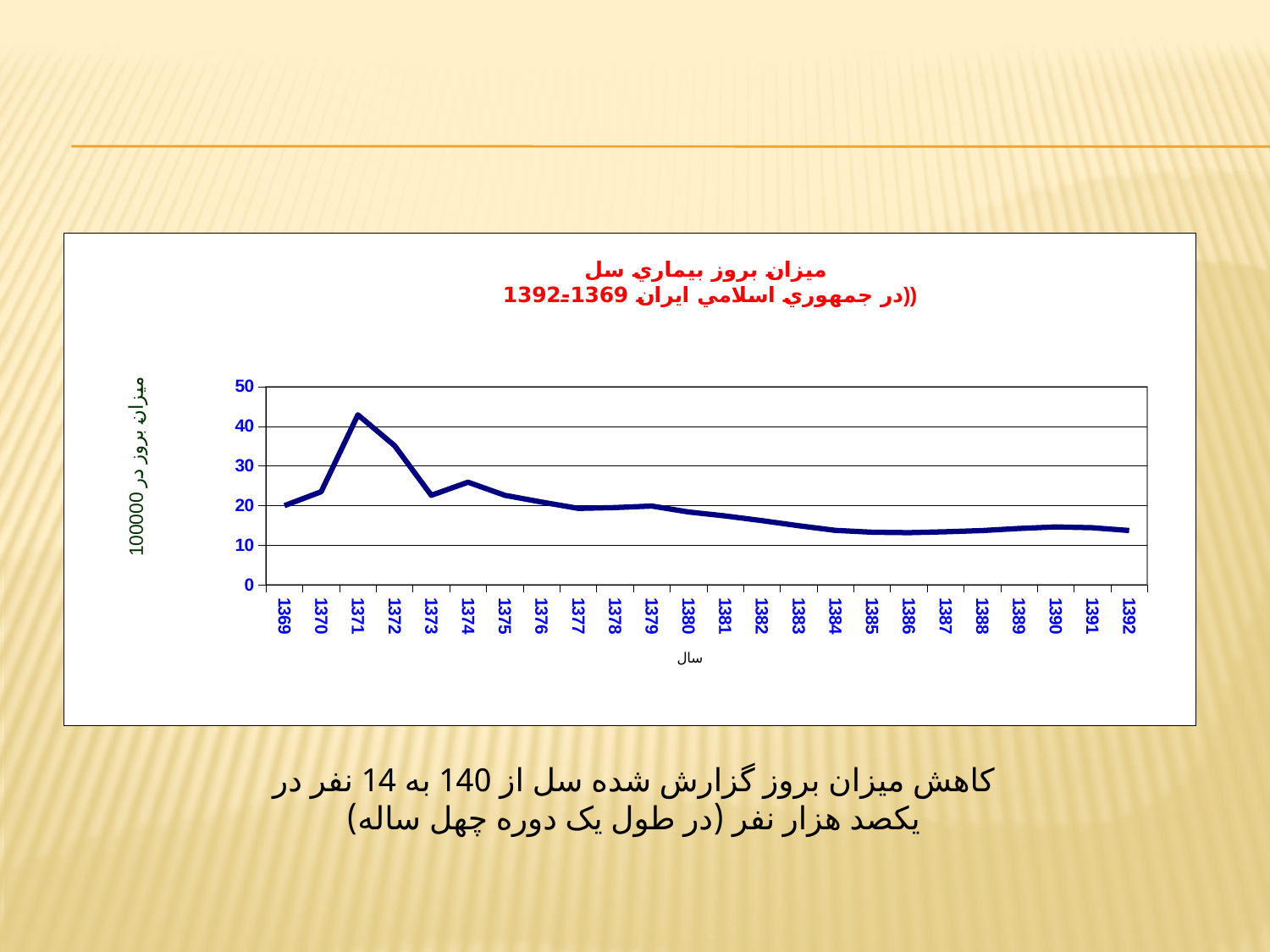
Which year has the highest incidence rate in the chart? 1371 Is the value for 1392 greater or less than 20? less What kind of chart is shown on the slide? line chart What is the label on the x axis of the chart? سال Is the value for 1371 greater or less than 40? greater Which year has the larger value, 1371 or 1373? 1371 Overall, do the values rise or fall from 1371 to 1392? fall Is the value for 1372 greater or less than 30? greater Which year has the larger value, 1372 or 1385? 1372 How many years are plotted along the x axis of the chart? 24